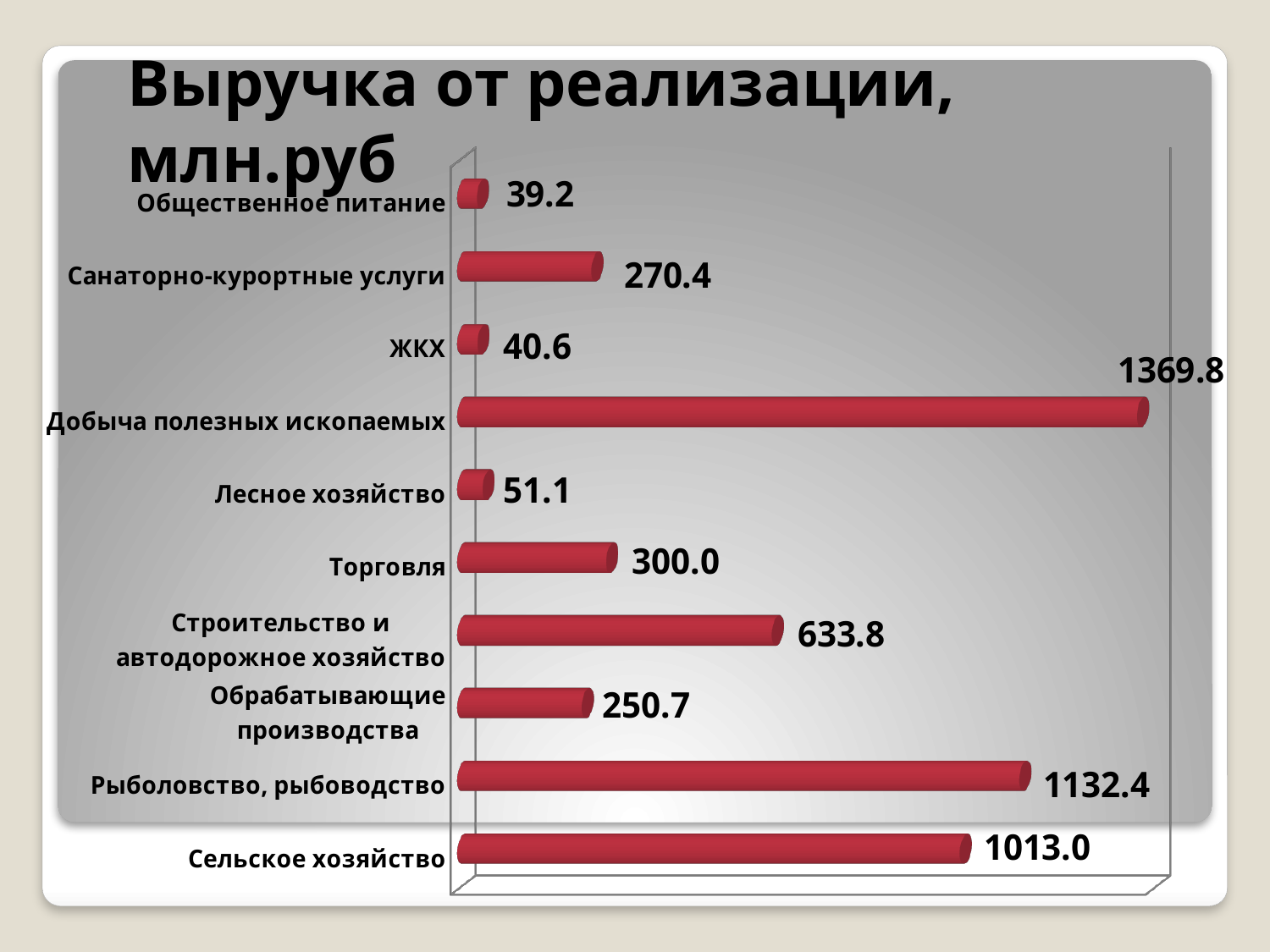
What is the value for Добыча полезных ископаемых? 1369.8 What is the title of the chart? Выручка от реализации, млн.руб What is the difference between the values for Рыболовство, рыбоводство and Сельское хозяйство? 119.4 What is the difference between the values for Строительство и автодорожное хозяйство and Торговля? 333.8 What is the value for Рыболовство, рыбоводство? 1132.4 How many categories are shown in the chart? 10 Which is larger, the value for Санаторно-курортные услуги or the value for Обрабатывающие производства? Санаторно-курортные услуги What is the value for Торговля? 300.0 What is the value for Общественное питание? 39.2 Which category has the highest value? Добыча полезных ископаемых What kind of chart is shown on the slide? Bar chart Which category has the lowest value? Общественное питание